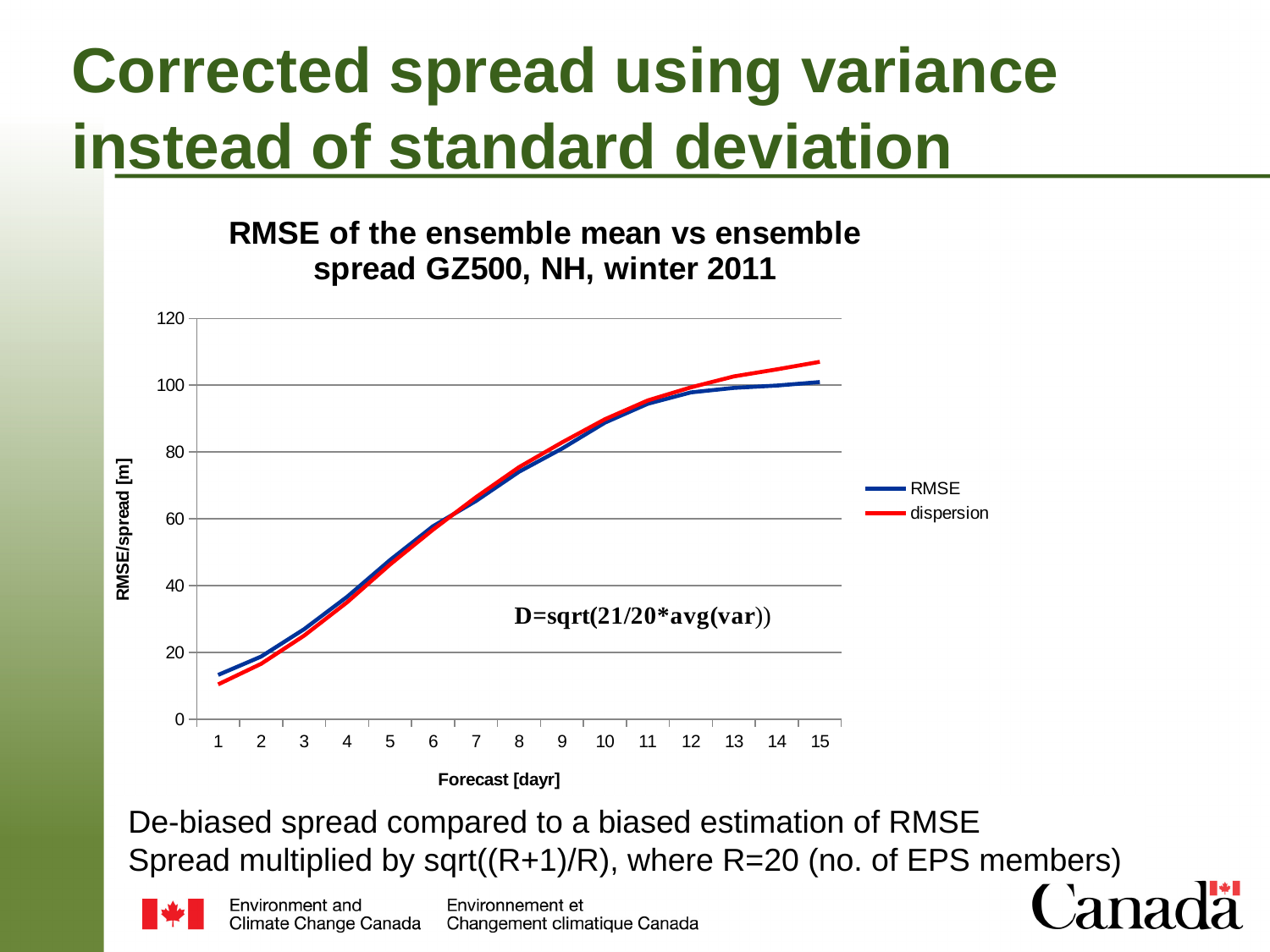
Is the dispersion value at forecast day 15 greater or less than 100? greater Is the RMSE value at forecast day 10 greater or less than 80? greater At forecast day 1, which series has the larger value, RMSE or dispersion? RMSE Do the RMSE values rise or fall as the forecast day increases? rise How many forecast days are plotted along the x axis? 15 Is the RMSE value at forecast day 8 greater or less than 80? less What kind of chart is shown on the slide? line chart How many series does the legend list? 2 At forecast day 15, which series has the larger value, RMSE or dispersion? dispersion What is the label of the x axis? Forecast [dayr]